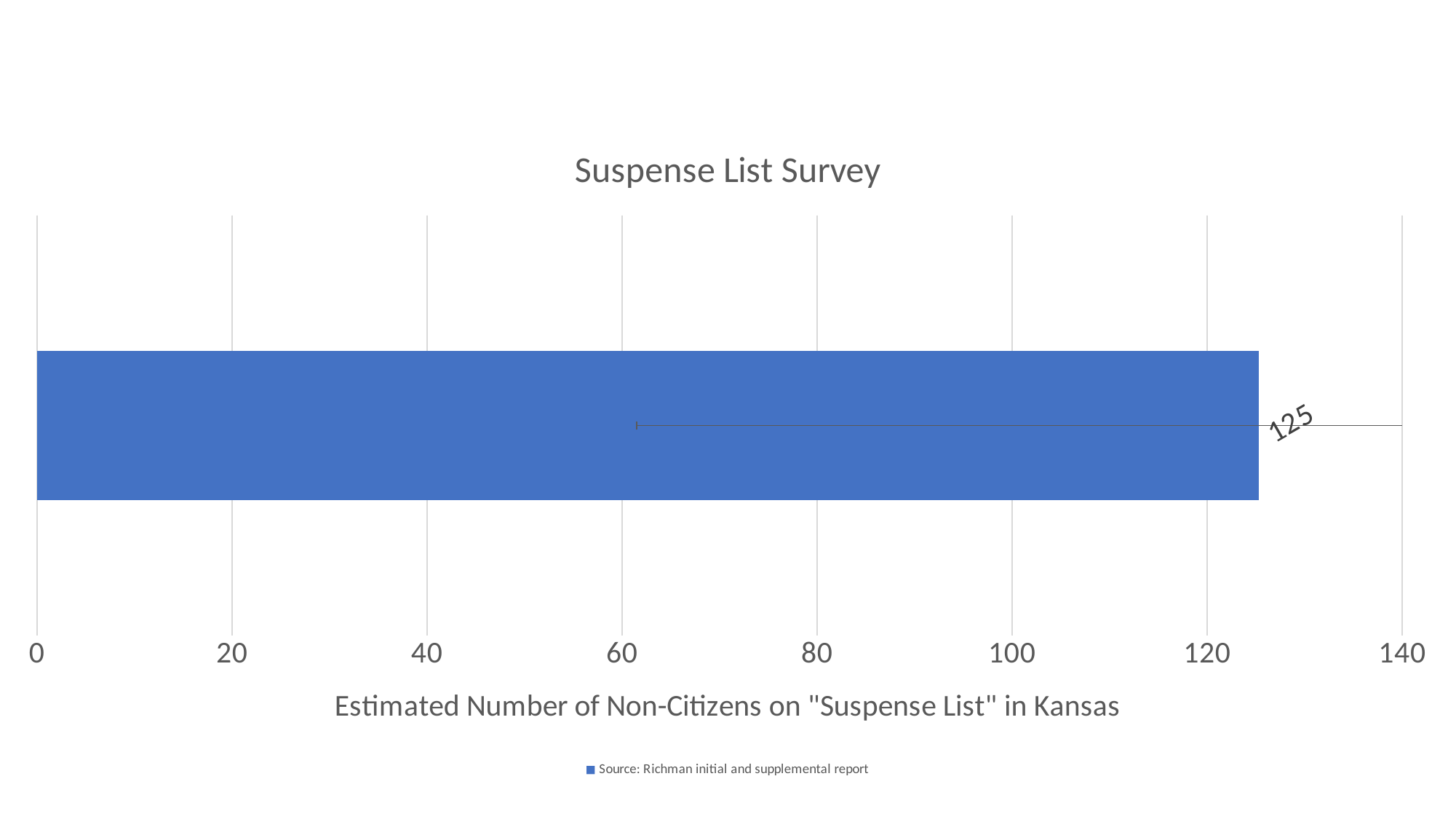
Is the value of the bar greater or less than 100? greater How many bars are plotted in the chart? 1 Is the value of the bar greater or less than 140? less What is the title of the chart? Suspense List Survey Is the value of the bar greater or less than 120? greater What kind of chart is shown on the slide? bar chart What is the legend entry shown below the chart? Source: Richman initial and supplemental report What is the value shown by the data label on the bar in the Suspense List Survey chart? 125 How many series does the legend list? 1 What is the estimated number of non-citizens on the "Suspense List" in Kansas according to the chart? 125